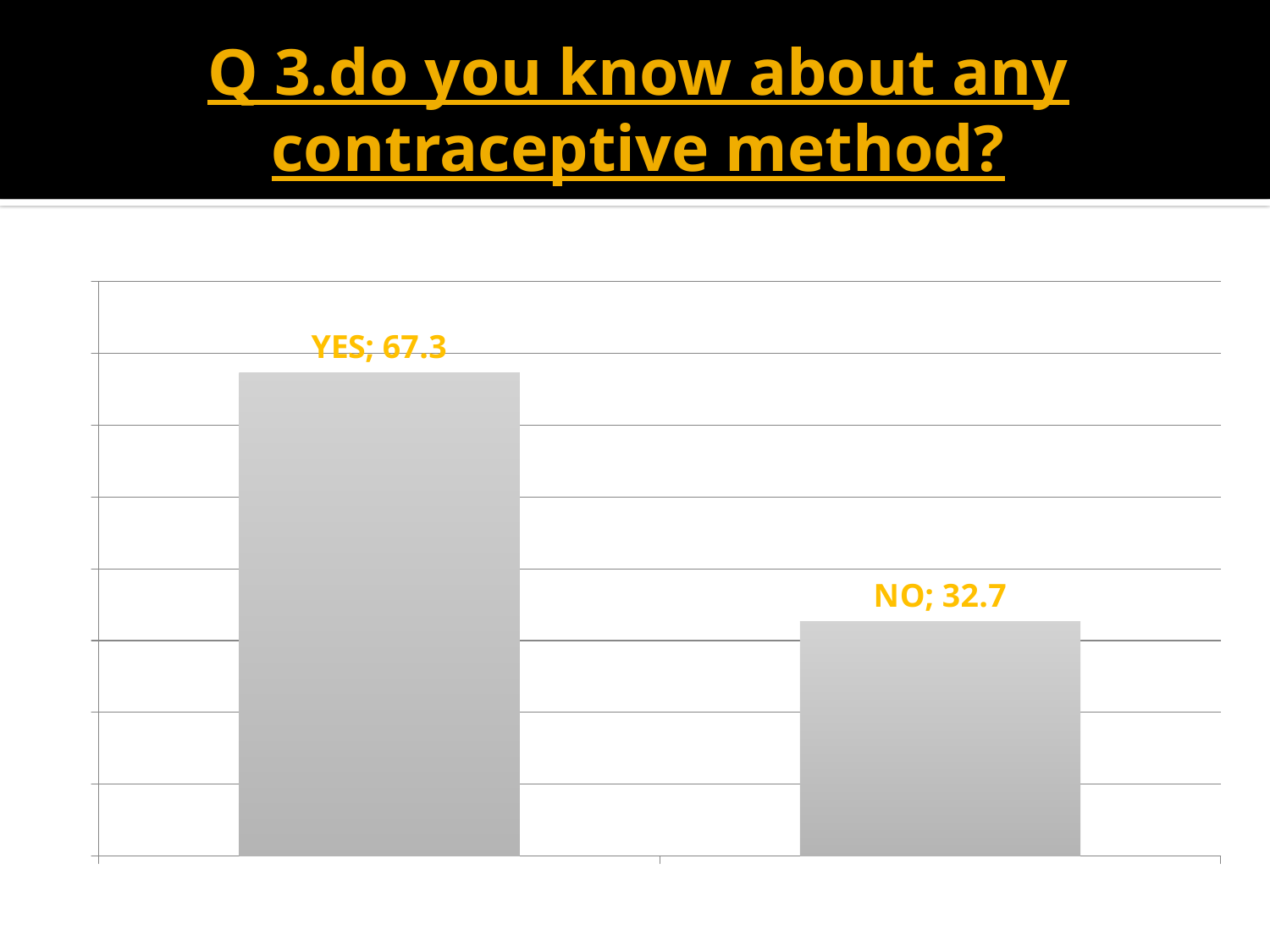
Do the values rise or fall from YES to NO along the x axis? fall Which category has the lowest value? NO What kind of chart is shown on the slide? bar chart How many categories are shown in the chart? 2 What is the value for YES? 67.3 Which category has the highest value? YES What is the total of the values for YES and NO? 100 What is the difference between the values for YES and NO? 34.6 What is the value for NO? 32.7 Which is larger, the value for YES or the value for NO? YES What is the title of the slide containing the chart? Q 3.do you know about any contraceptive method?